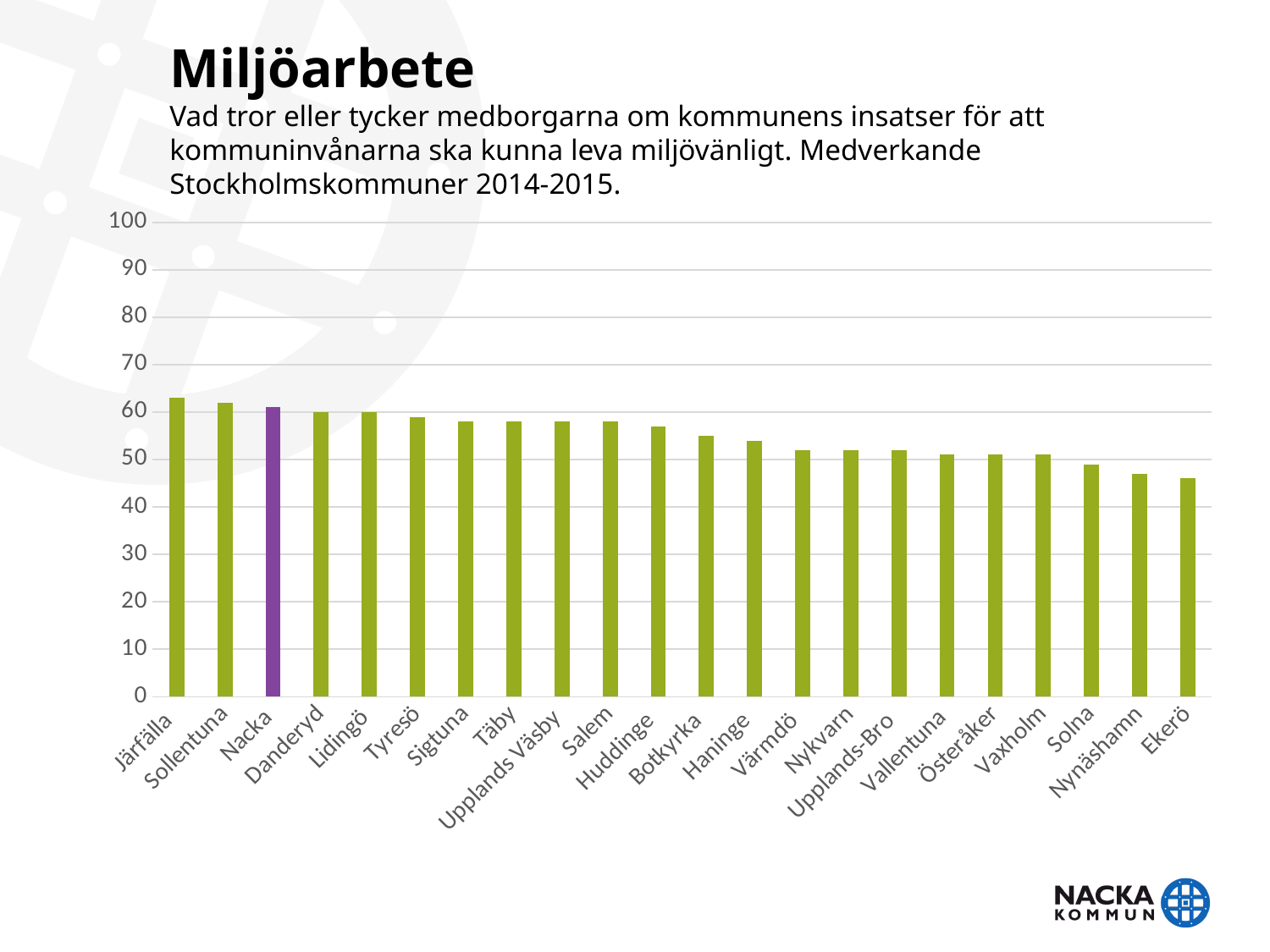
Is the value for Botkyrka greater or less than 60? less Is the value for Haninge greater or less than 60? less Is the value for Vaxholm greater or less than 40? greater Which municipality's bar is shown in a different colour (purple) from the others? Nacka How many municipalities (bars) are shown in the chart? 22 What kind of chart is shown on the slide? bar chart Which has the larger value, Järfälla or Ekerö? Järfälla Which has the larger value, Nacka or Solna? Nacka Do the values rise or fall moving from left to right along the x axis? fall